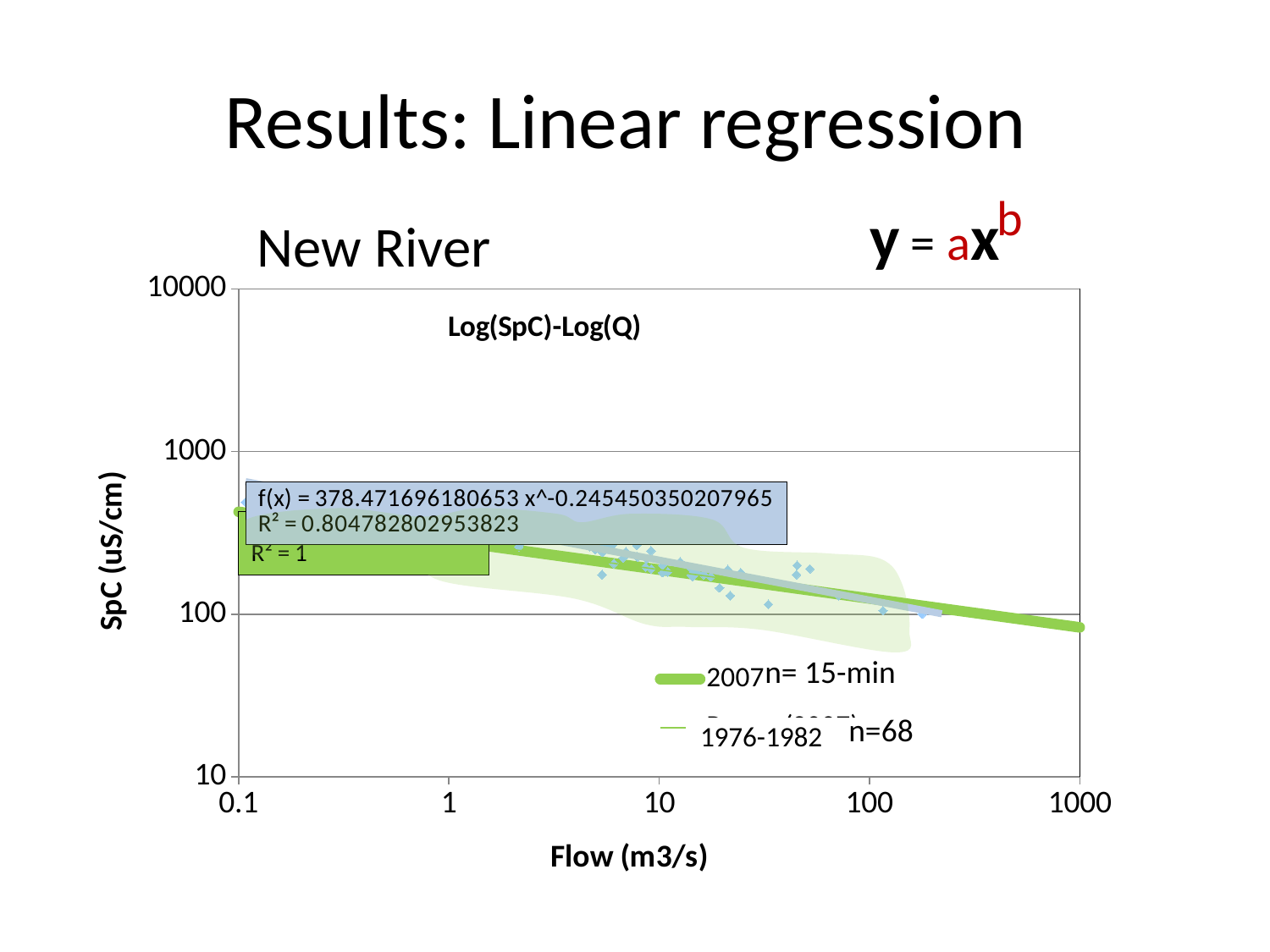
What is the lowest tick value shown on the x axis? 0.1 What is the R² value shown in the blue trendline label on the chart? 0.804782802953823 What is the R² value shown in the green label on the chart? 1 What is the highest tick value shown on the x axis? 1000 What is the highest tick value shown on the y axis? 10000 As flow increases along the x axis, does SpC rise or fall? Fall What is the label of the x axis of the chart? Flow (m3/s) What is the trendline equation shown in the blue label on the chart? f(x) = 378.471696180653 x^-0.245450350207965 What kind of chart is shown on the slide? Scatter chart What is the lowest tick value shown on the y axis? 10 What is the title of the chart? Log(SpC)-Log(Q)